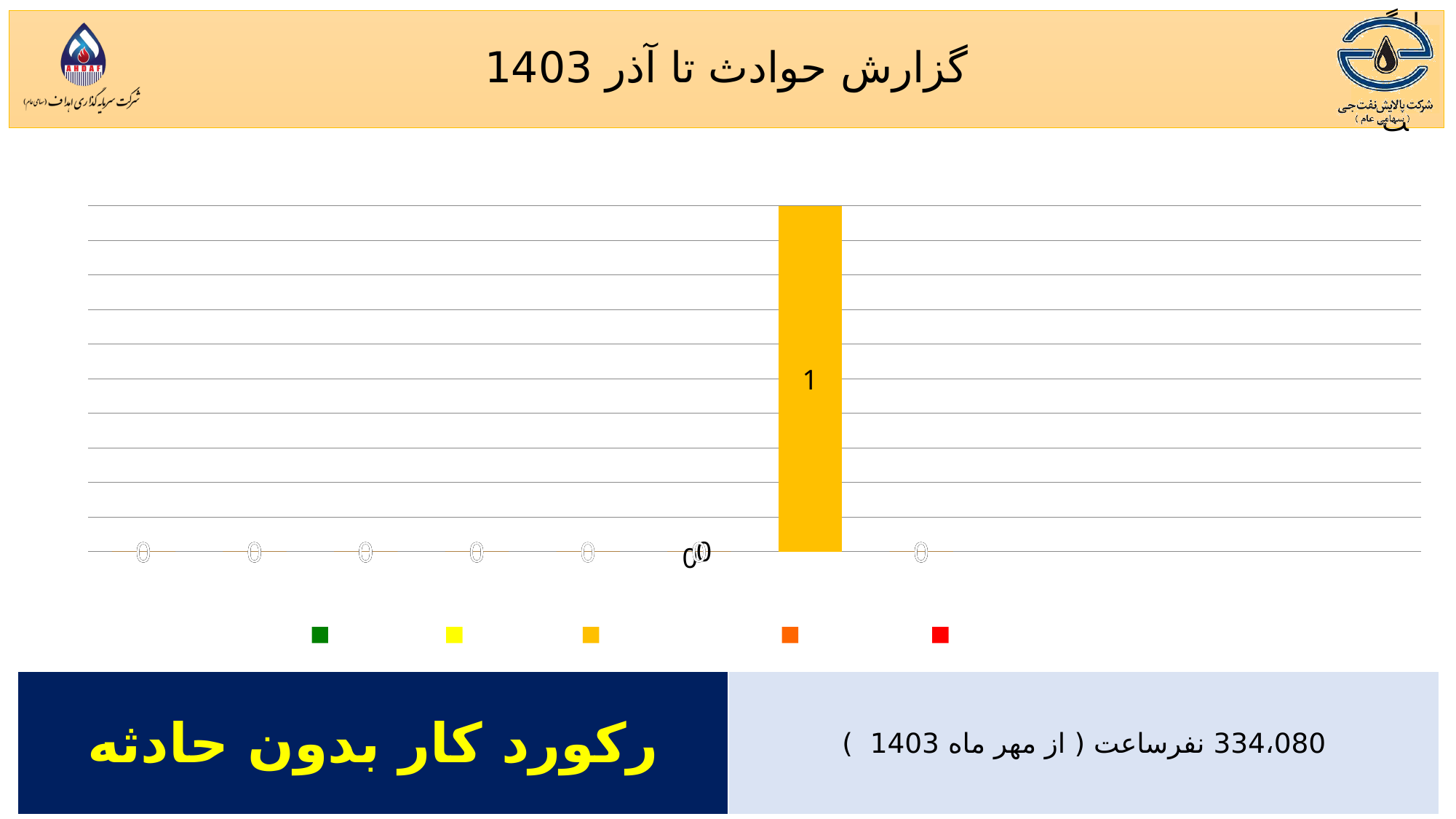
What value is printed for the bars other than the tallest one? 0 How many coloured legend markers are shown below the chart? 5 Is the value of the tallest bar greater or less than 0? greater What value is printed on the tallest bar in the chart? 1 How many bars in the chart have a non-zero value? 1 What kind of chart is shown on the slide? bar chart